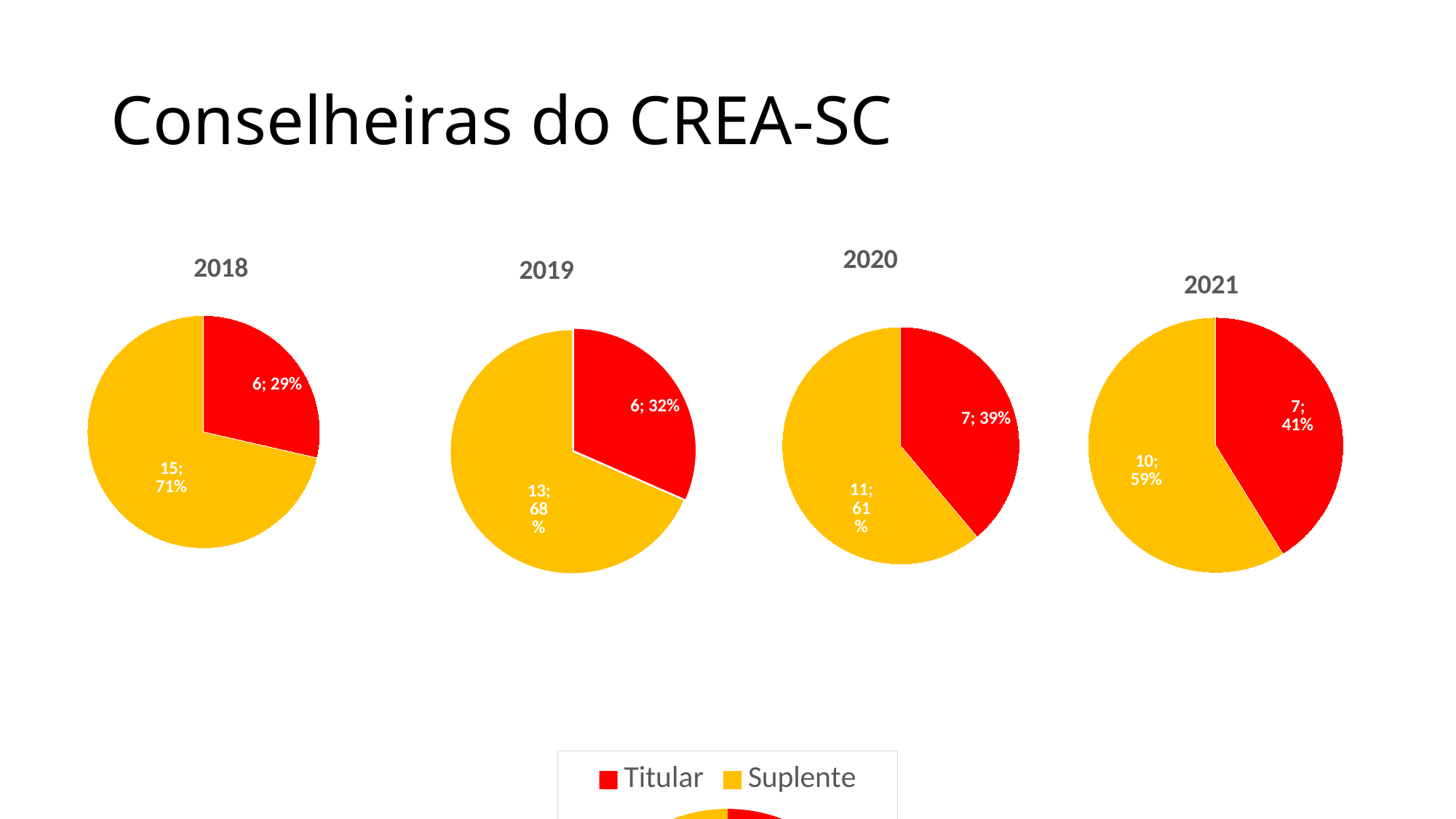
How many series does the legend list? 2 How many pie charts with year titles are shown on the slide? 4 In the 2018 pie chart, what is the value shown for Titular? 6; 29% In the 2019 pie chart, what is the value shown for Suplente? 13; 68% In the 2018 pie chart, what share of the pie does Suplente take? 71% What kind of chart is used for the 2019 data? Pie chart In the 2020 pie chart, what is the difference between the Suplente count and the Titular count? 4 In the 2021 pie chart, which slice is larger, Titular or Suplente? Suplente In the 2018 pie chart, what is the total of the Titular and Suplente counts? 21 Which colour represents Titular in the legend? Red In the 2020 pie chart, what share of the pie does Titular take? 39% In the 2021 pie chart, what is the value shown for Suplente? 10; 59%